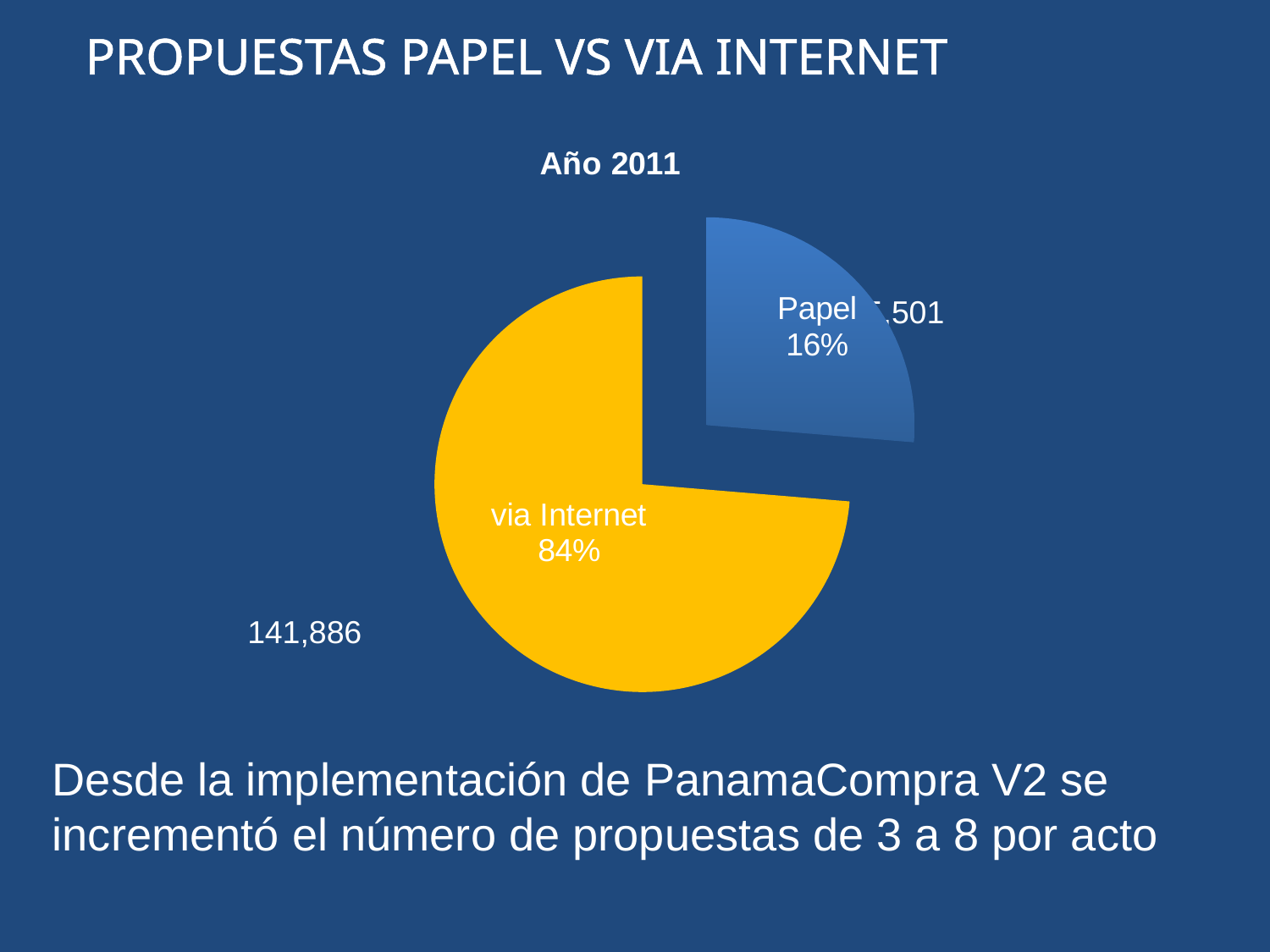
What kind of chart is shown on the slide? pie chart How many slices does the pie chart have? 2 What is the difference in percentage points between the 'via Internet' share and the 'Papel' share? 68 What is the value shown for 'via Internet'? 141,886 Which slice of the pie chart is the smallest? Papel Which slice of the pie chart is the largest? via Internet What percentage of the pie does the 'via Internet' slice represent? 84% Which is larger, the share for 'Papel' or the share for 'via Internet'? via Internet What percentage of the pie does the 'Papel' slice represent? 16% What is the title of the chart? Año 2011 What colour is the 'via Internet' slice? yellow